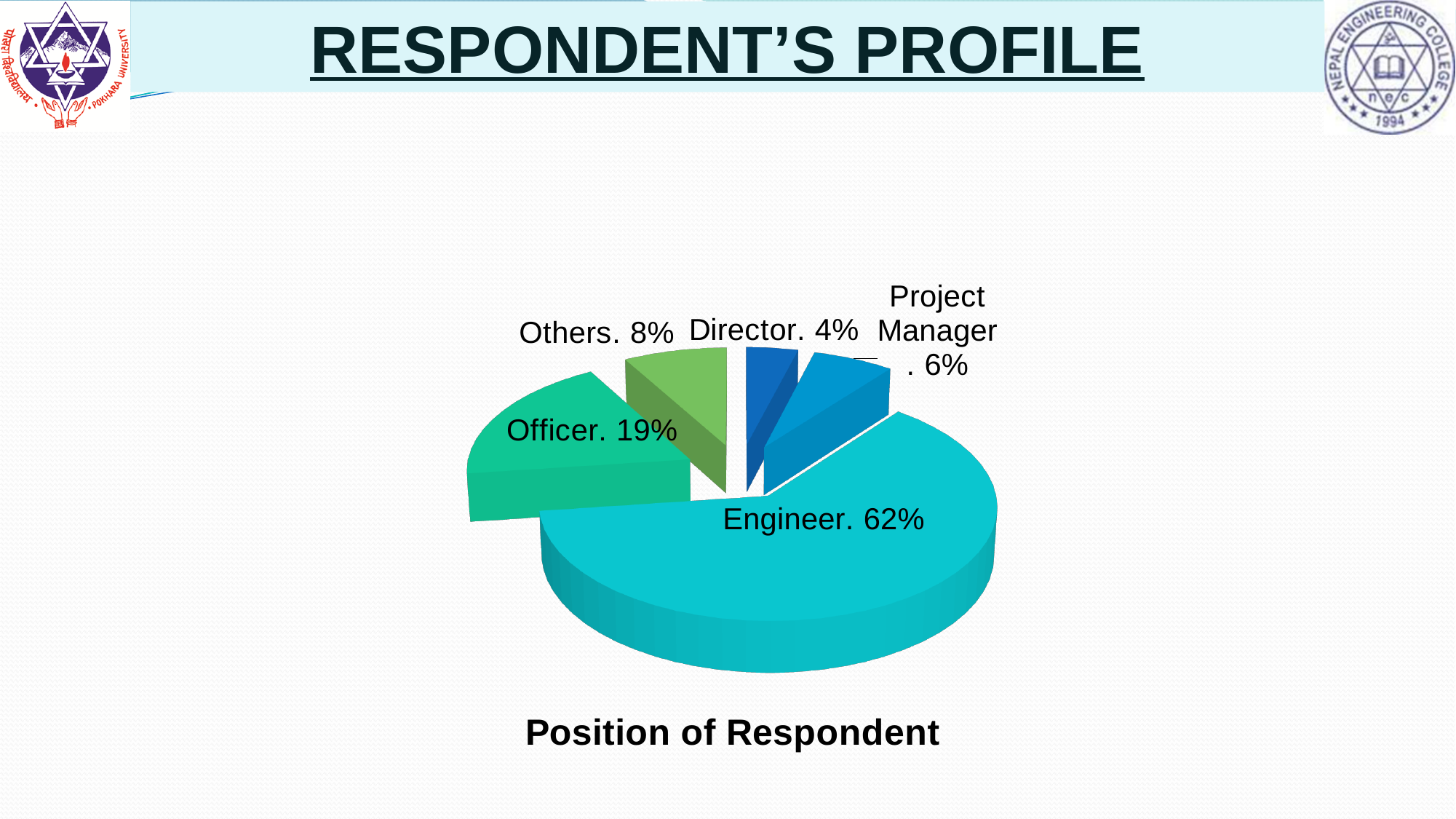
What is the difference in percentage points between Engineer and Officer? 43 What percentage of respondents fall under Others? 8% What percentage of respondents are Project Managers? 6% Which position has the smallest share of respondents? Director What percentage of respondents are Officers? 19% What is the title shown below the pie chart? Position of Respondent What percentage of respondents are Directors? 4% What percentage of respondents are Engineers? 62% Which position has the largest share of respondents? Engineer Which is larger, the share for Others or the share for Project Manager? Others What kind of chart is shown on the slide? Pie chart How many positions (slices) are shown in the pie chart? 5